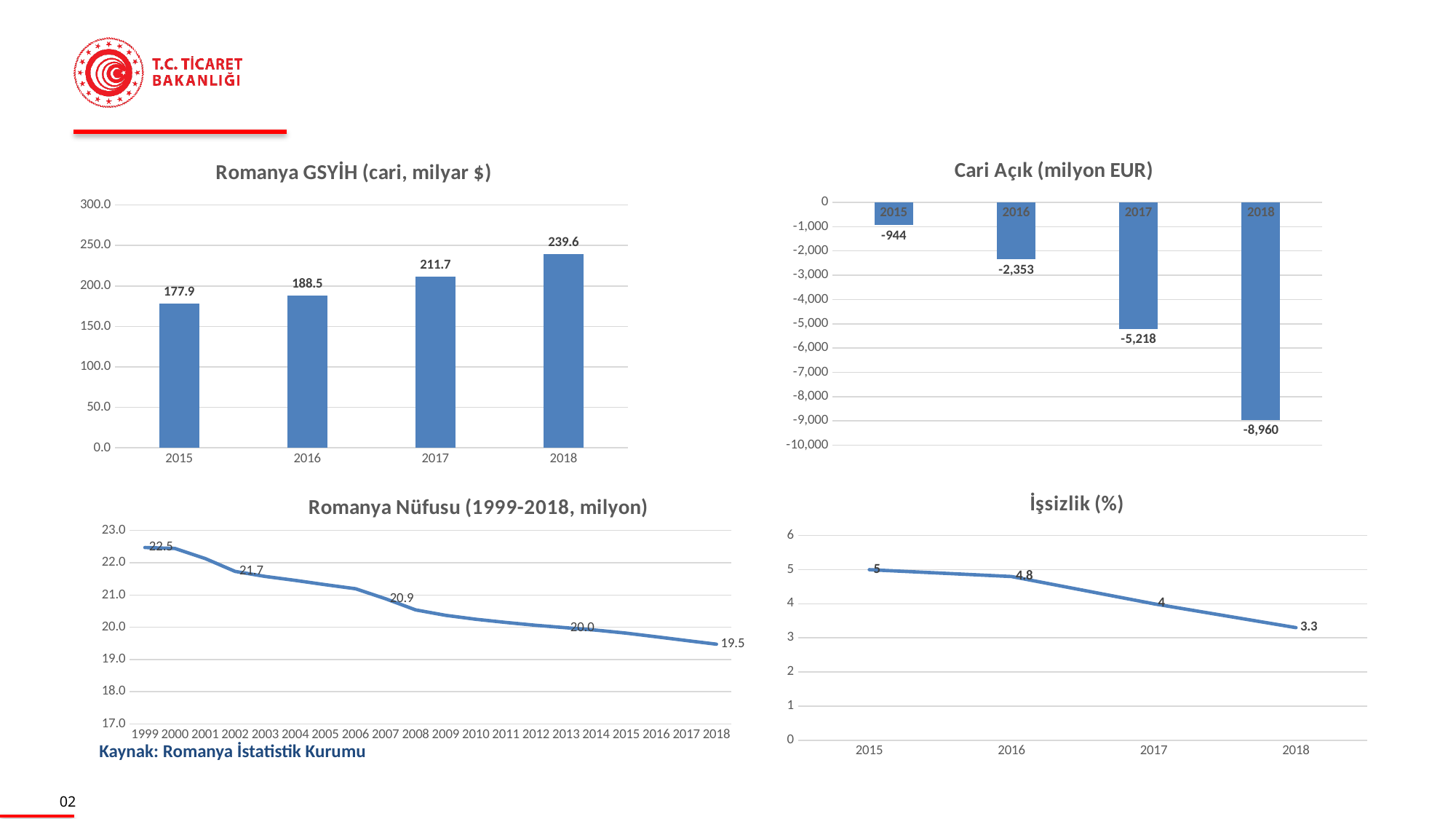
In the 'İşsizlik (%)' chart, what is the value for 2016? 4.8 In the 'Romanya GSYİH (cari, milyar $)' chart, what is the difference between the 2018 and 2015 values? 61.7 What kind of chart is 'Romanya Nüfusu (1999-2018, milyon)'? line chart In the 'Romanya GSYİH (cari, milyar $)' chart, what is the value for 2017? 211.7 In the 'İşsizlik (%)' chart, what is the difference between the 2015 and 2018 values? 1.7 In the 'Romanya Nüfusu (1999-2018, milyon)' chart, do the values rise or fall from 1999 to 2018? fall In the 'Romanya Nüfusu (1999-2018, milyon)' chart, what is the value labelled for 2018? 19.5 How many years are shown in the 'Cari Açık (milyon EUR)' chart? 4 In the 'Cari Açık (milyon EUR)' chart, which year has the lowest (most negative) value? 2018 In the 'Cari Açık (milyon EUR)' chart, what is the value for 2016? -2,353 In the 'Romanya GSYİH (cari, milyar $)' chart, which year has the highest value? 2018 What kind of chart is 'Romanya GSYİH (cari, milyar $)'? bar chart